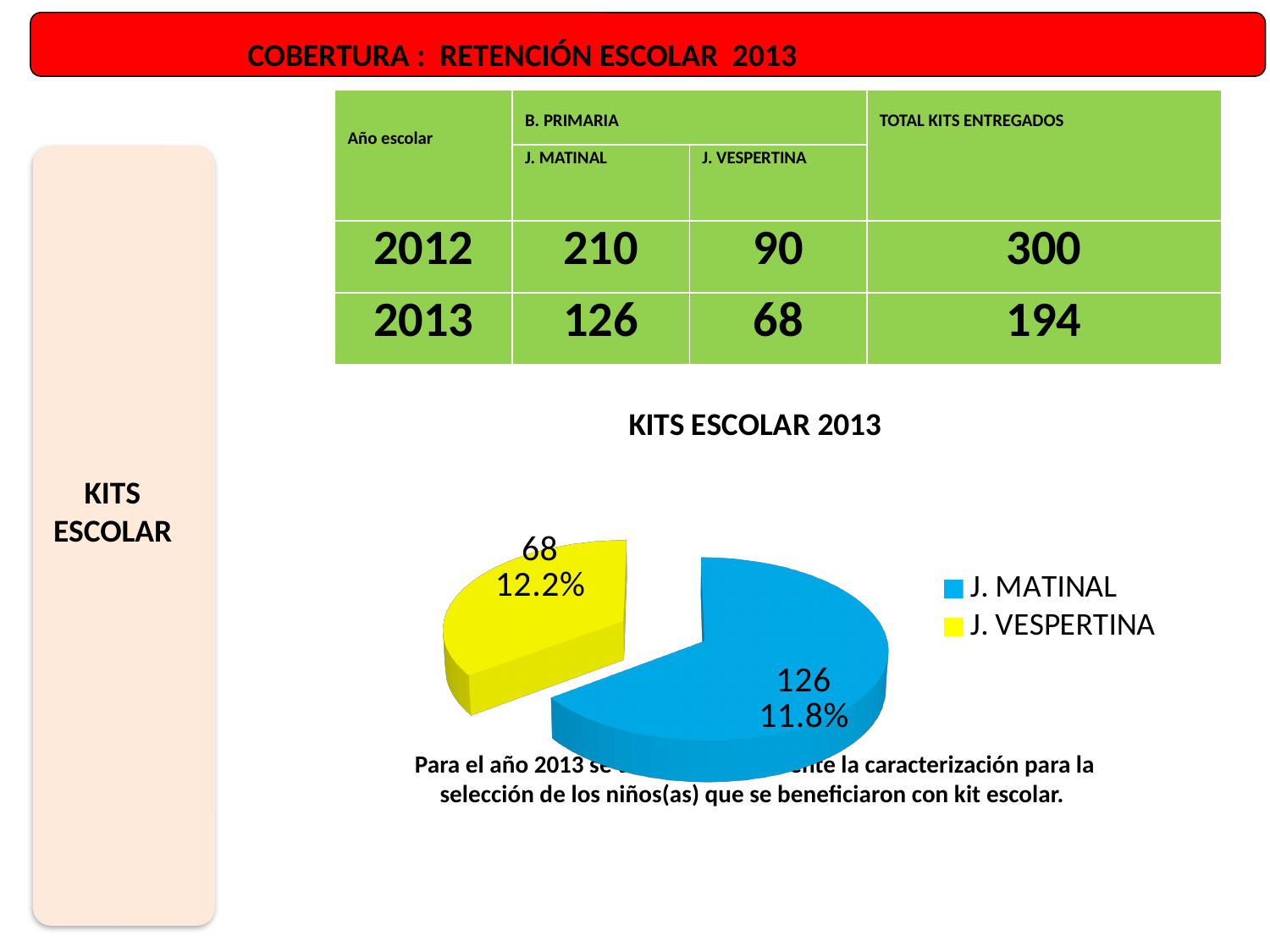
Which is larger in the pie chart, J. MATINAL or J. VESPERTINA? J. MATINAL Which slice of the pie chart is the largest? J. MATINAL What is the value shown for J. MATINAL in the pie chart? 126 What type of chart is shown under the title KITS ESCOLAR 2013? pie chart What is the difference between the J. MATINAL and J. VESPERTINA values in the pie chart? 58 What colour is the J. VESPERTINA slice in the pie chart? yellow What is the value shown for J. VESPERTINA in the pie chart? 68 How many entries does the pie chart legend list? 2 What percentage label is printed on the J. VESPERTINA slice of the pie chart? 12.2% What is the title of the pie chart? KITS ESCOLAR 2013 How many slices does the pie chart have? 2 Which slice of the pie chart is the smallest? J. VESPERTINA